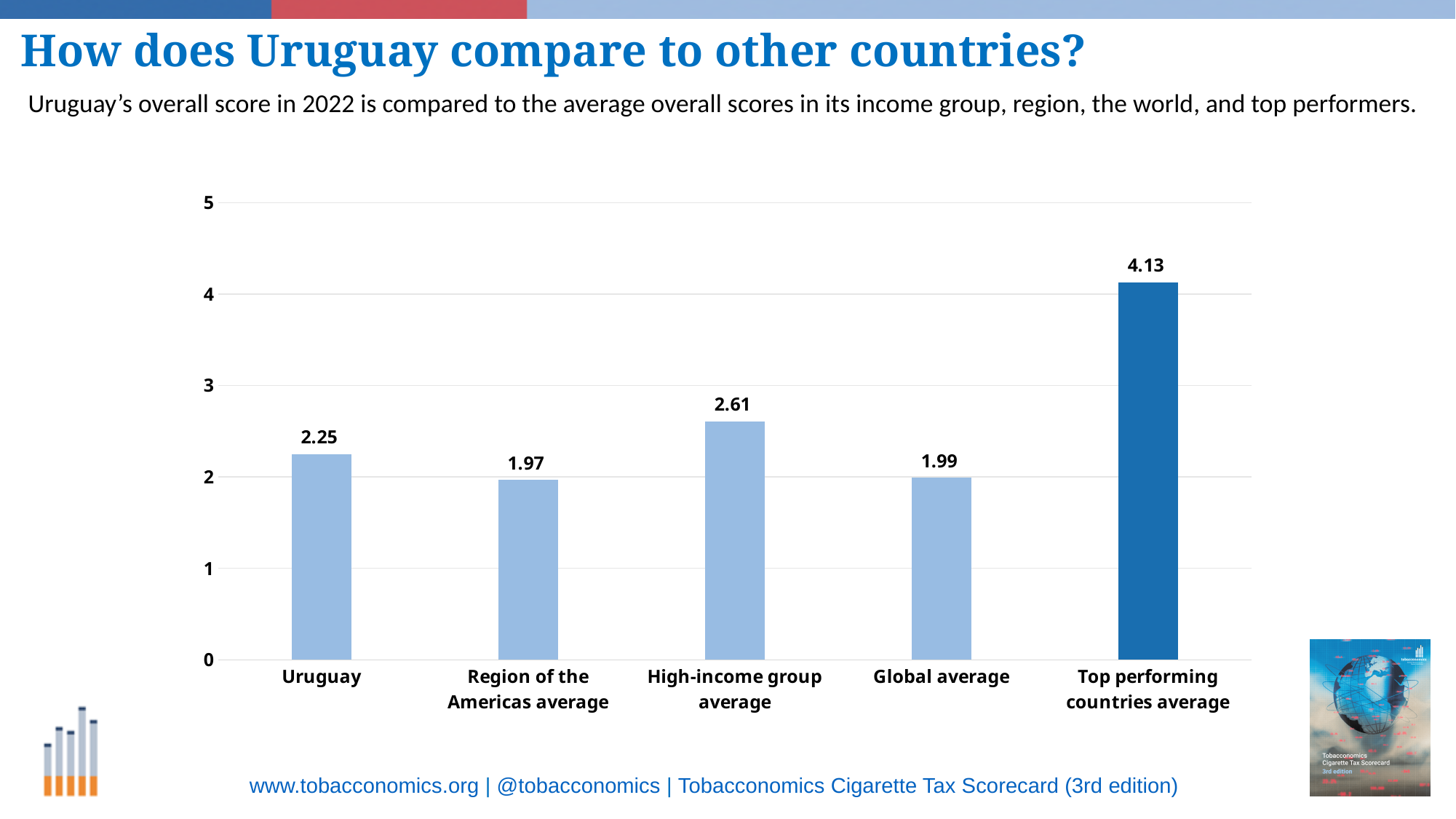
Which category has the lowest value? Region of the Americas average What is the value for the Top performing countries average? 4.13 Which is larger, Uruguay or the Global average? Uruguay How many categories are shown on the chart? 5 What kind of chart is shown on the slide? Bar chart What is the value for the Region of the Americas average? 1.97 What is the value for Uruguay? 2.25 Which bar is shown in a darker blue than the others? Top performing countries average Which category has the highest value? Top performing countries average What is the difference between the Top performing countries average and Uruguay? 1.88 What is the value for the High-income group average? 2.61 What is the value for the Global average? 1.99